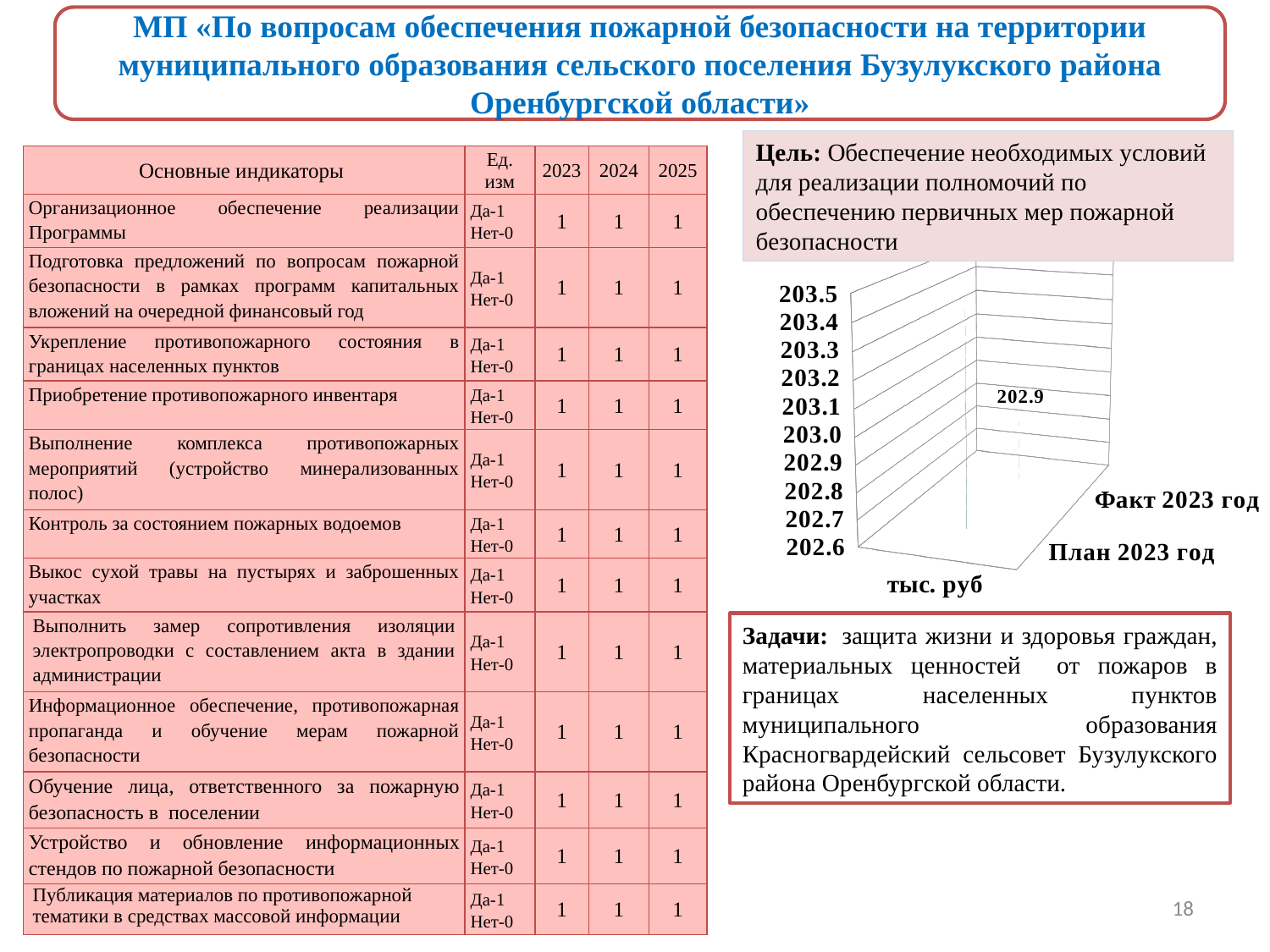
What unit label is printed below the chart's axis? тыс. руб What kind of chart is shown on the right side of the slide? bar chart What are the two category labels on the chart? План 2023 год, Факт 2023 год What data label value is printed on the chart? 202.9 What is the highest tick value shown on the chart's vertical axis? 203.5 Is the data label value printed on the chart greater or less than 203.0? less How many categories are shown on the chart's horizontal axis? 1 What is the lowest tick value shown on the chart's vertical axis? 202.6